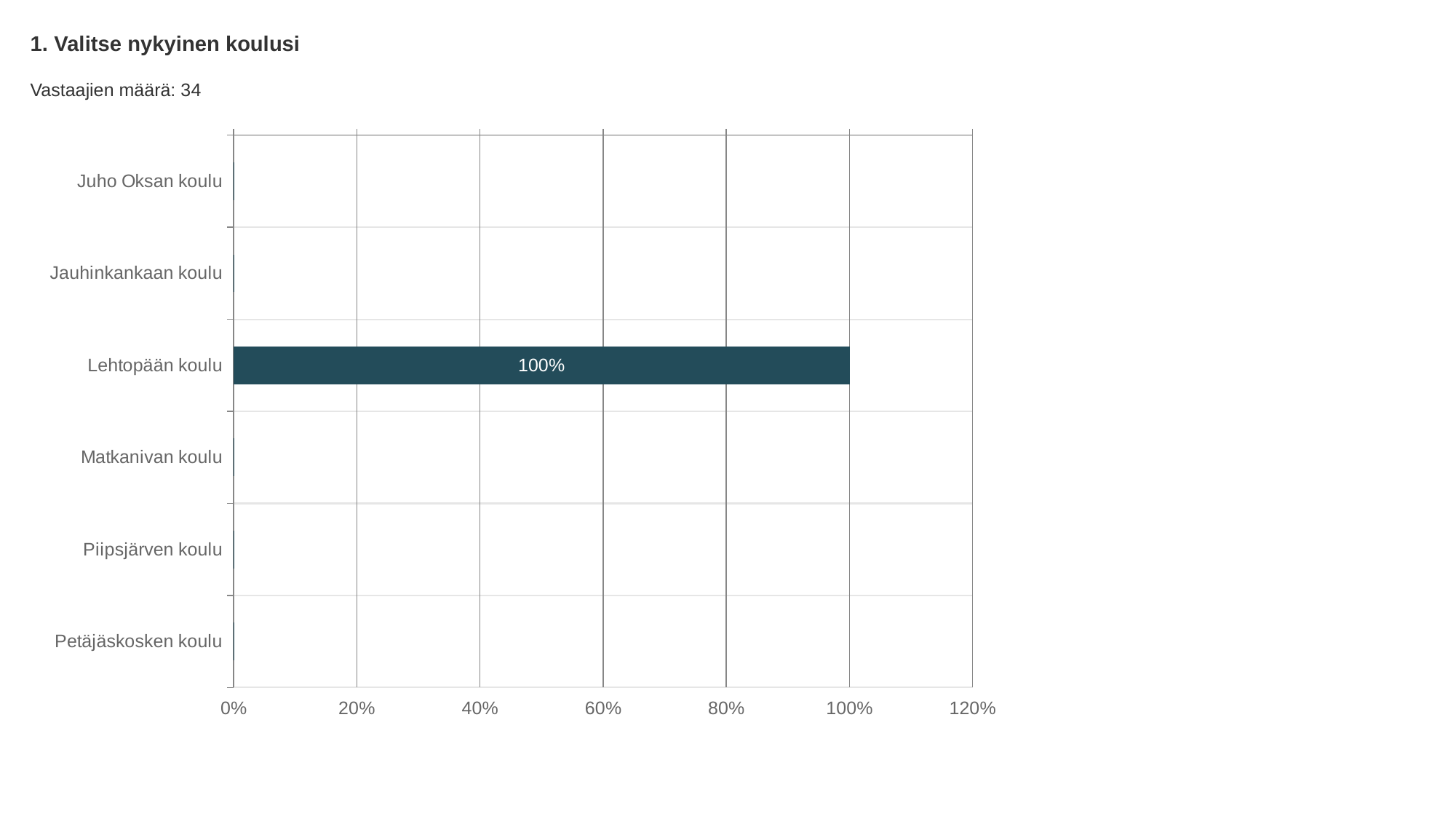
What is the value for Lehtopään koulu? 100% How many categories are shown on the y axis? 6 Which is larger, the value for Lehtopään koulu or the value for Matkanivan koulu? Lehtopään koulu What is the number of respondents (Vastaajien määrä) shown on the slide? 34 Is the value for Lehtopään koulu greater or less than 80%? greater What is the title of the chart? 1. Valitse nykyinen koulusi What is the highest tick value shown on the x axis? 120% What kind of chart is shown on the slide? bar chart How many categories have a visible bar? 1 Which category has the highest value? Lehtopään koulu